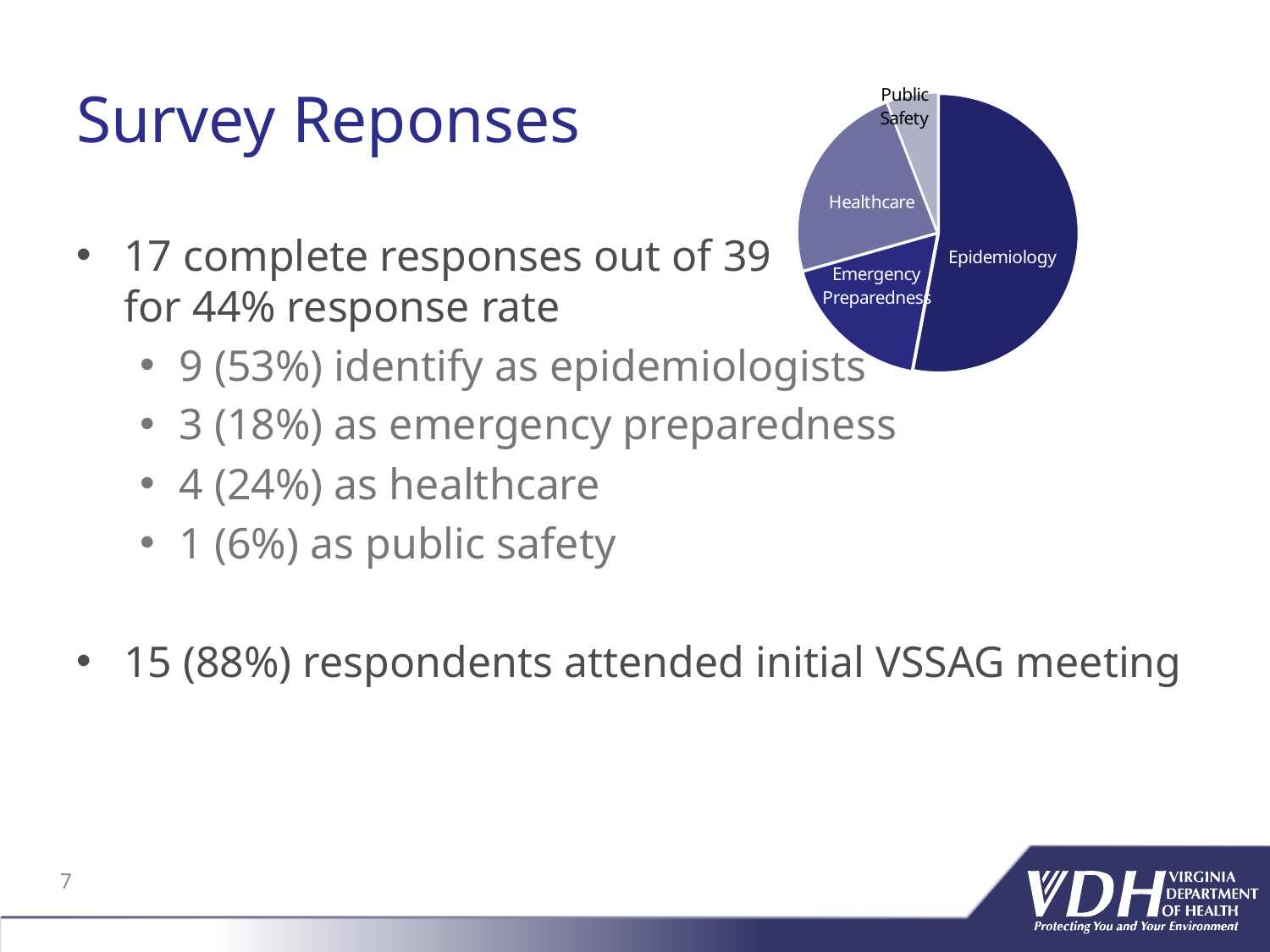
Does the pie chart have a legend? No How many slices does the pie chart have? 4 How many respondents does the Emergency Preparedness slice represent, according to the slide? 3 Which slice is larger in the pie chart, Emergency Preparedness or Public Safety? Emergency Preparedness Which slice is larger in the pie chart, Epidemiology or Healthcare? Epidemiology What kind of chart is shown on the slide? pie chart What share of the pie does the Epidemiology slice represent, according to the slide? 53% Which slice of the pie chart is the smallest? Public Safety What share of the pie does the Healthcare slice represent, according to the slide? 24% Which slice of the pie chart is labelled in the top-left area of the pie? Public Safety Which slice of the pie chart is the largest? Epidemiology What share of the pie does the Public Safety slice represent, according to the slide? 6%